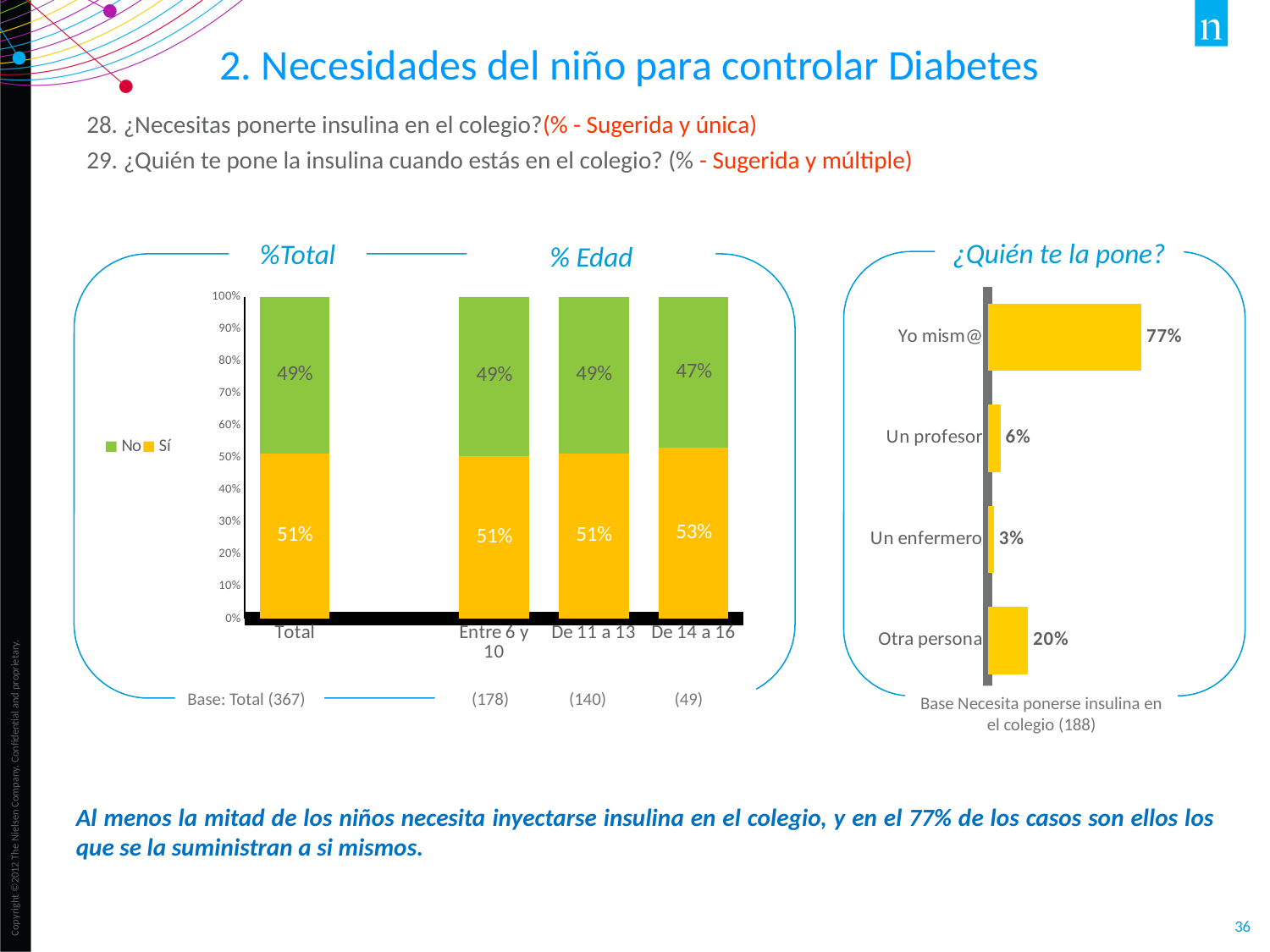
In the '¿Quién te la pone?' chart, which category has the lowest value? Un enfermero What kind of chart is the '¿Quién te la pone?' chart? Bar chart In the stacked bar chart on the left, what is the value of 'No' for 'Total'? 49% In the stacked bar chart on the left, what is the value of 'No' for 'De 14 a 16'? 47% In the stacked bar chart on the left, how many series does the legend list? 2 In the stacked bar chart on the left, what is the value of 'Sí' for 'De 14 a 16'? 53% In the '¿Quién te la pone?' chart, what is the value for 'Yo mism@'? 77% In the stacked bar chart on the left, which colour represents 'Sí'? Yellow In the '¿Quién te la pone?' chart, which is larger, 'Un profesor' or 'Otra persona'? Otra persona In the stacked bar chart on the left, how many categories are shown on the x axis? 4 In the stacked bar chart on the left, what is the total of the 'Sí' and 'No' values for 'Entre 6 y 10'? 100% In the '¿Quién te la pone?' chart, what is the difference between 'Otra persona' and 'Un profesor'? 14%